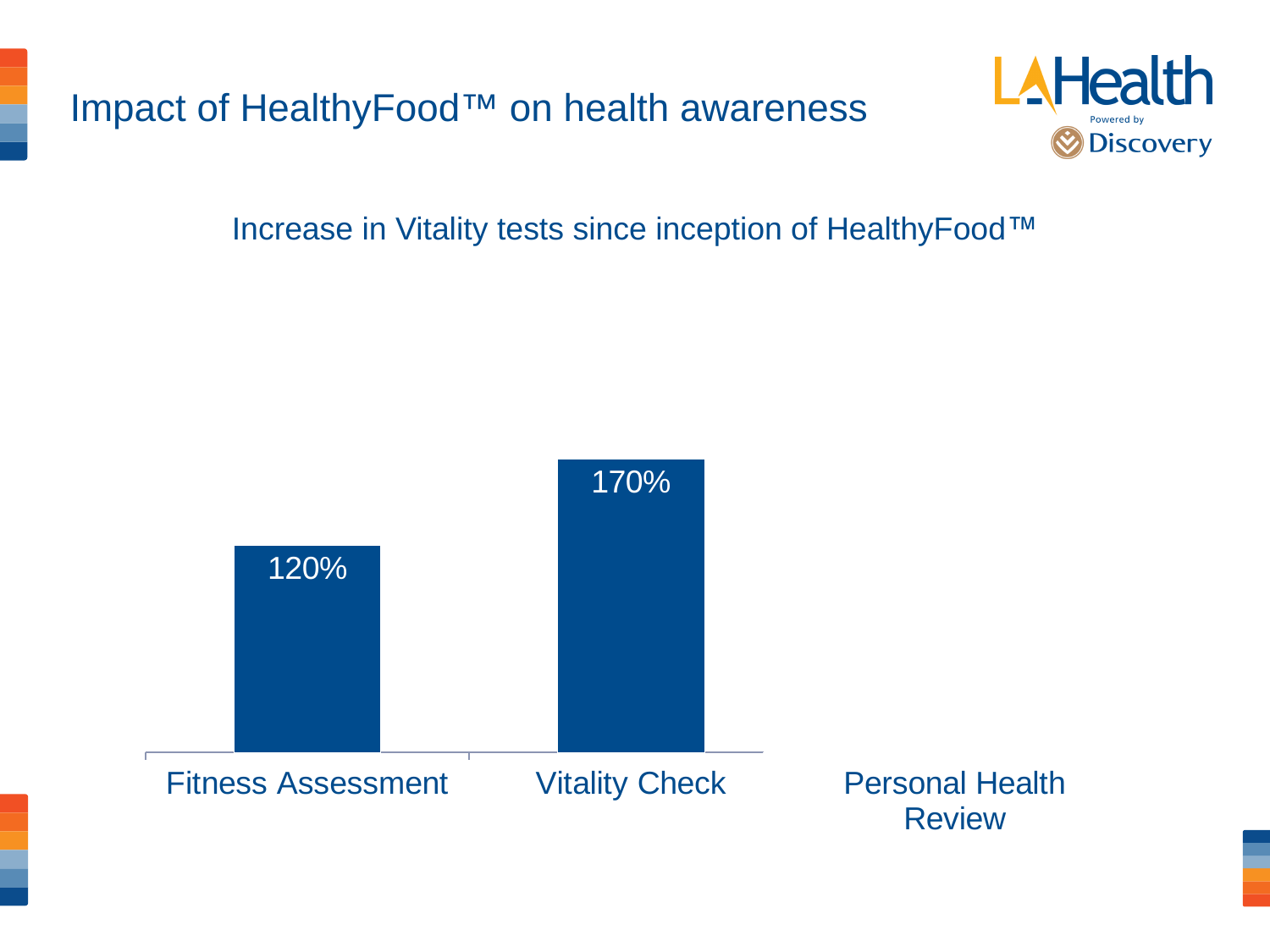
What kind of chart is shown on the slide? Bar chart Which category has the highest bar in the chart? Vitality Check Which is larger, the value for Fitness Assessment or the value for Vitality Check? Vitality Check What is the title of the chart? Increase in Vitality tests since inception of HealthyFood™ What is the difference between the Vitality Check value and the Fitness Assessment value? 50% What is the label of the third category on the x axis, which has no bar plotted? Personal Health Review Does the value rise or fall from Fitness Assessment to Vitality Check? Rise How many bars are actually plotted in the chart? 2 What is the value shown for Vitality Check? 170% What is the value shown for Fitness Assessment? 120% How many category labels are shown along the x axis of the chart? 3